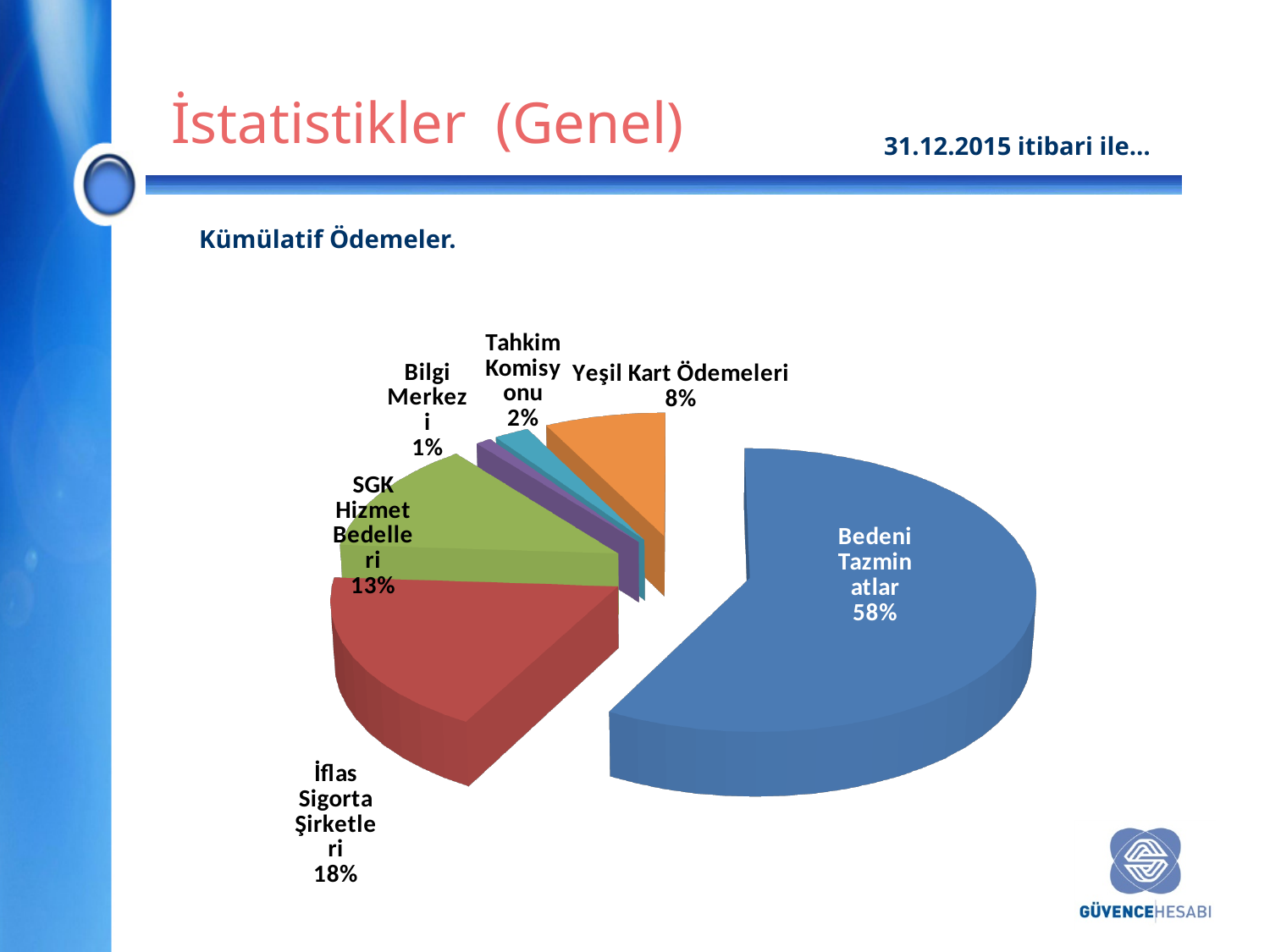
What share of the pie does Bedeni Tazminatlar represent? 58% What is the difference in percentage points between Bedeni Tazminatlar and İflas Sigorta Şirketleri? 40 What is the title of the chart? Kümülatif Ödemeler. Which category has the largest slice of the pie? Bedeni Tazminatlar What kind of chart is shown on the slide? Pie chart What percentage is shown for Tahkim Komisyonu? 2% What percentage is shown for SGK Hizmet Bedelleri? 13% What percentage is shown for İflas Sigorta Şirketleri? 18% What percentage is shown for Yeşil Kart Ödemeleri? 8% Which is larger, the share for SGK Hizmet Bedelleri or the share for Yeşil Kart Ödemeleri? SGK Hizmet Bedelleri How many categories are shown in the pie chart? 6 Which category has the smallest slice of the pie? Bilgi Merkezi